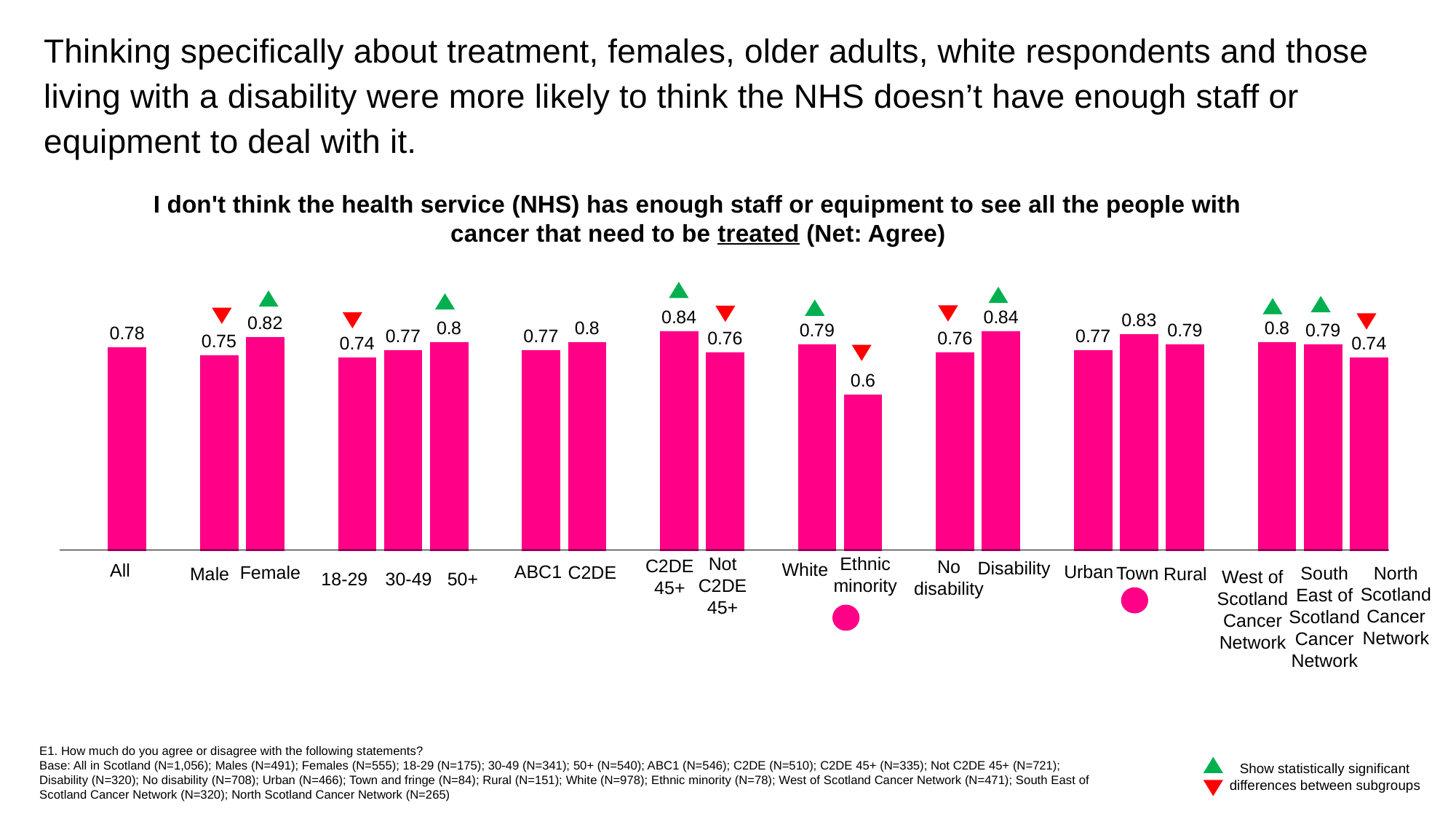
How many bars are plotted in the chart? 20 What kind of chart is shown on the slide? Bar chart Which is larger, the value for 18-29 or the value for 50+? 50+ What is the value for North Scotland Cancer Network? 0.74 Which category has the lowest value? Ethnic minority What is the difference between the values for Female and Male? 0.07 What is the value for Town? 0.83 Which is larger, the value for C2DE 45+ or the value for Not C2DE 45+? C2DE 45+ What is the value for Female? 0.82 What is the difference between the values for Disability and No disability? 0.08 What is the value for All respondents? 0.78 What is the value for Ethnic minority? 0.6